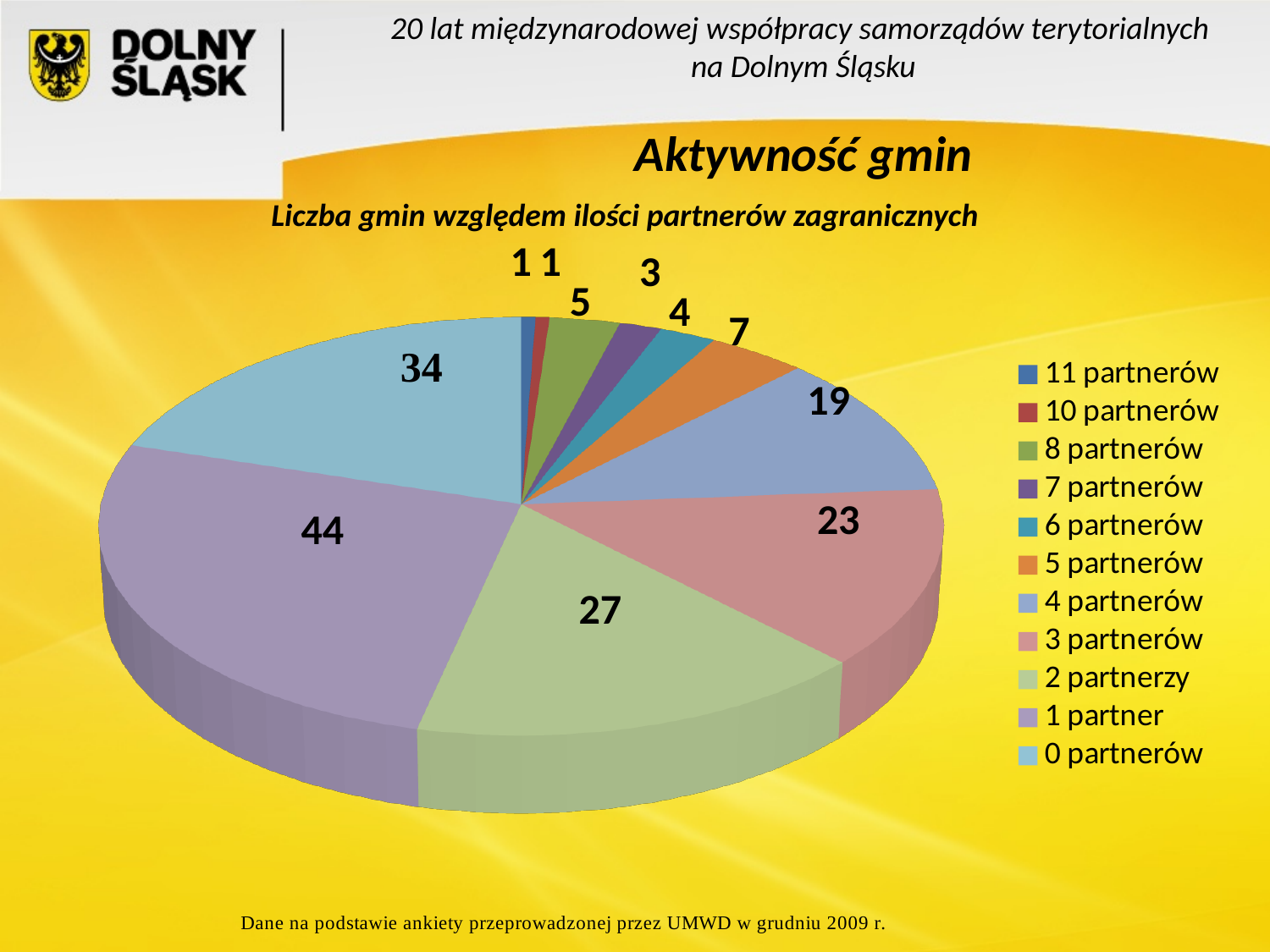
What is the subtitle of the chart? Liczba gmin względem ilości partnerów zagranicznych How many gminy have 0 partnerów? 34 Which is larger, the value for 2 partnerzy or the value for 3 partnerów? 2 partnerzy How many gminy have 1 partner according to the pie chart? 44 What is the value for 4 partnerów? 19 What is the value for 3 partnerów? 23 Which category has the largest slice of the pie? 1 partner How many categories does the legend list? 11 What is the difference between the values for 1 partner and 0 partnerów? 10 What is the value for 5 partnerów? 7 What kind of chart is shown on the slide? pie chart What is the value for 2 partnerzy? 27